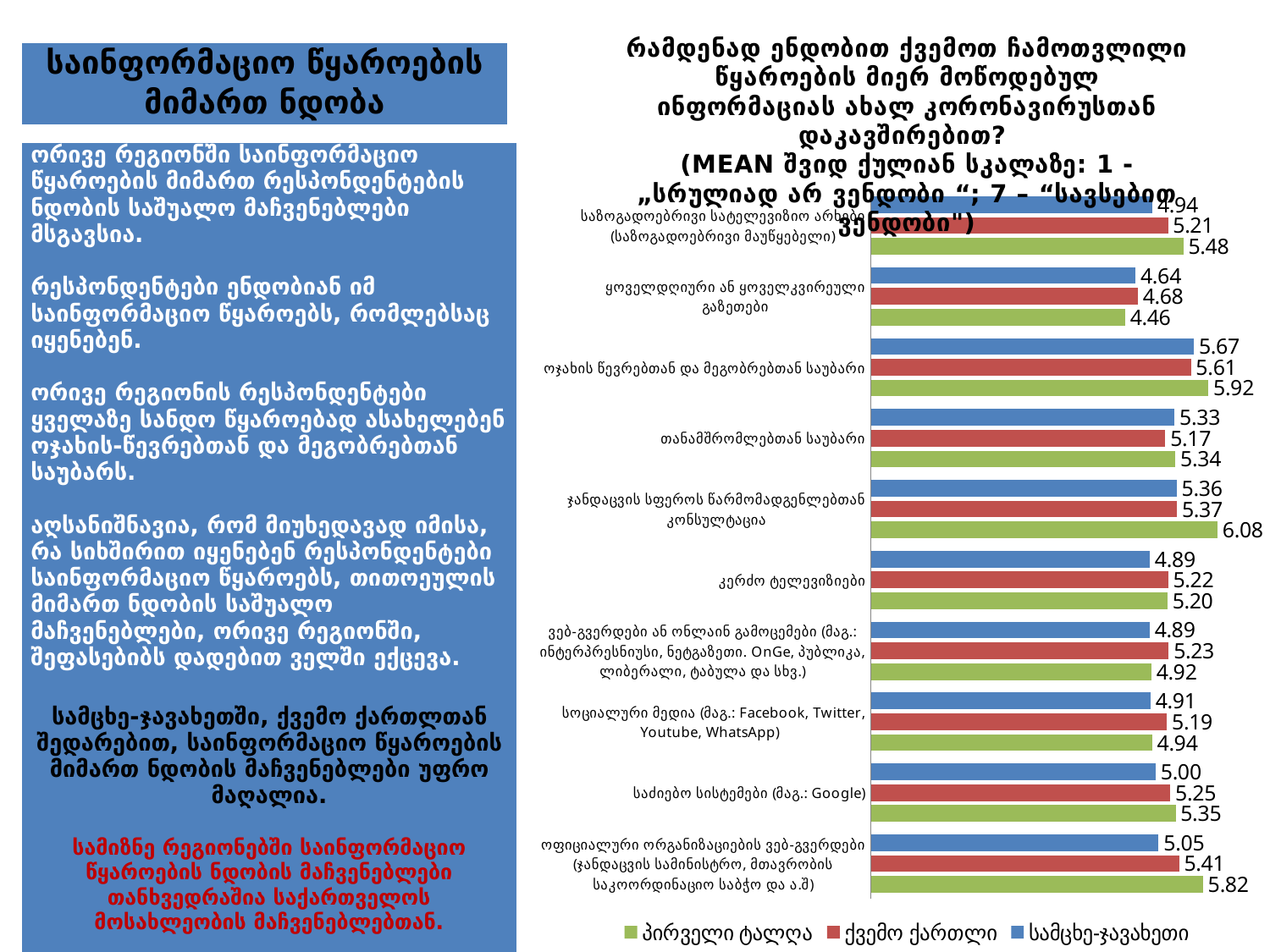
Which category has the highest value for the სამცხე-ჯავახეთი series? ოჯახის წევრებთან და მეგობრებთან საუბარი What is the difference between the პირველი ტალღა and სამცხე-ჯავახეთი values for ოფიციალური ორგანიზაციების ვებ-გვერდები? 0.77 For კერძო ტელევიზიები, which series has the larger value: ქვემო ქართლი or სამცხე-ჯავახეთი? ქვემო ქართლი What is the value for the ქვემო ქართლი series for საძიებო სისტემები (მაგ.: Google)? 5.25 How many categories (information sources) are plotted on the chart? 10 What is the value for the ქვემო ქართლი series for ყოველდღიური ან ყოველკვირეული გაზეთები? 4.68 Which category has the lowest value for the პირველი ტალღა series? ყოველდღიური ან ყოველკვირეული გაზეთები How many series does the chart legend list? 3 What type of chart is shown on the slide? bar chart What is the value for the პირველი ტალღა series for ჯანდაცვის სფეროს წარმომადგენლებთან კონსულტაცია? 6.08 What is the value for the სამცხე-ჯავახეთი series for ოჯახის წევრებთან და მეგობრებთან საუბარი? 5.67 Which colour represents the ქვემო ქართლი series in the chart? red